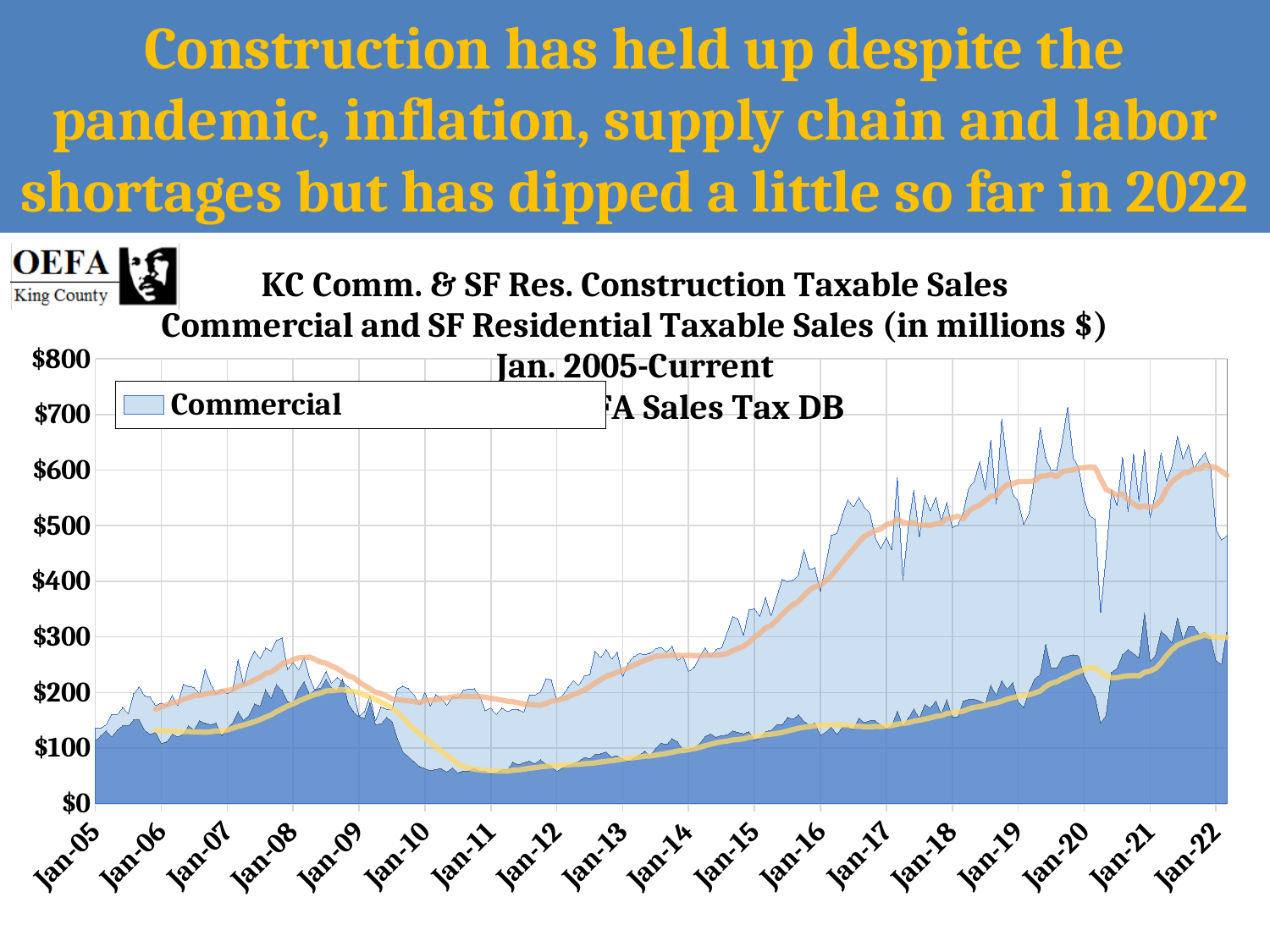
Is the value of the lower (dark blue) series at Jan-11 greater or less than $100? less Is the peak Commercial value near Jan-20 greater or less than $600? greater Is the Commercial value at Jan-22 greater or less than $400? greater Does the Commercial series generally rise or fall between Jan-12 and Jan-16? rise What kind of chart is shown on the slide? Area chart Does the Commercial series generally rise or fall between Jan-08 and Jan-10? fall What is the title of the chart? KC Comm. & SF Res. Construction Taxable Sales Which series name is readable in the chart's legend? Commercial What is the highest value shown on the y axis? $800 How many year labels (Jan-05 through Jan-22) are shown on the x axis? 18